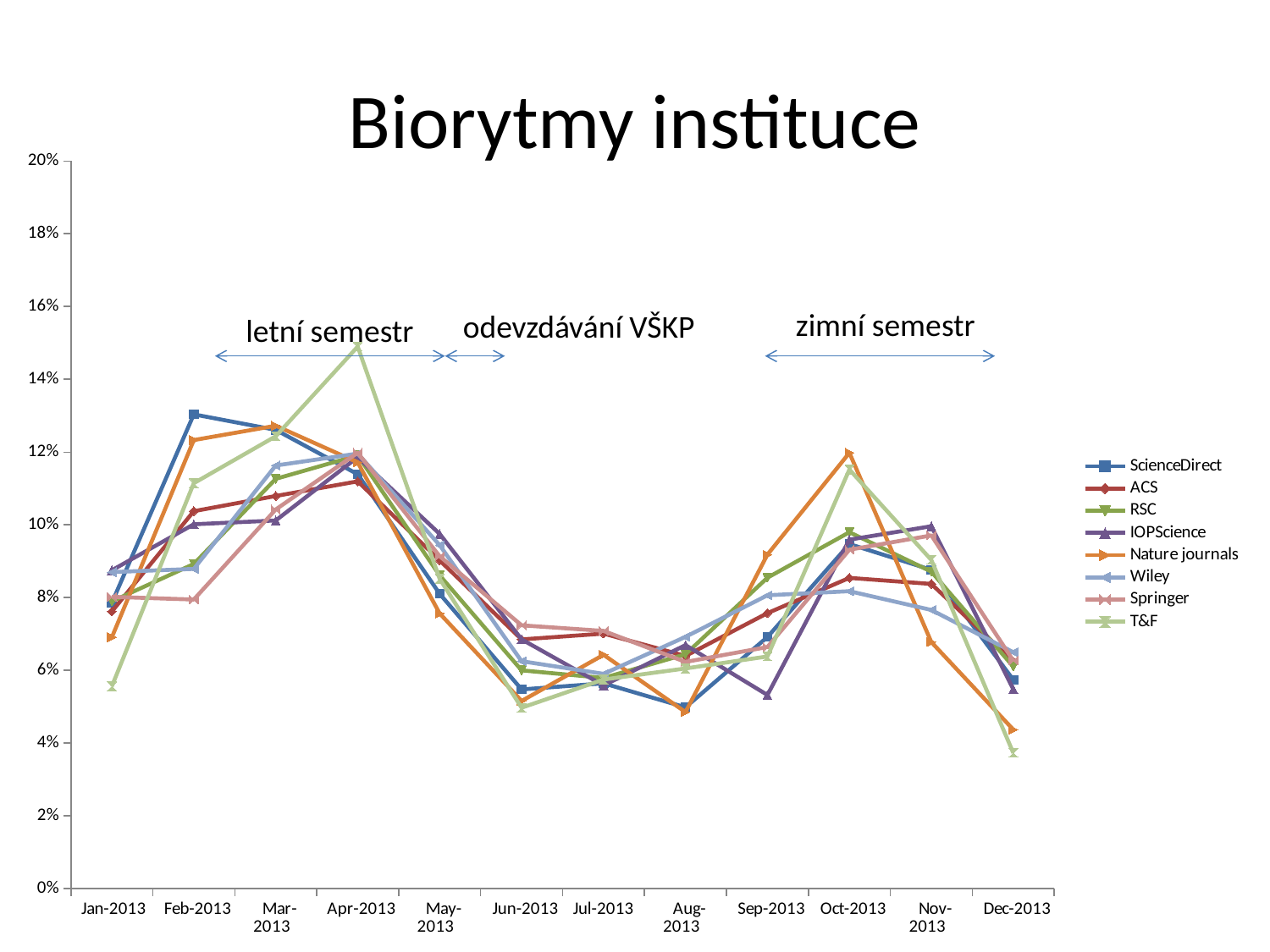
Which series has the lowest value in Jan-2013? T&F Which series reaches the highest value in Apr-2013? T&F How many series does the legend list? 8 What kind of chart is shown on the slide? line chart Is the value for IOPScience in Sep-2013 greater or less than 6%? less Is the value for Nature journals higher in Oct-2013 or in Nov-2013? Oct-2013 Which series has the highest value in Feb-2013? ScienceDirect Is the value for T&F in Apr-2013 greater or less than 14%? greater In which month does the T&F series reach its highest value? Apr-2013 Is the value for T&F in Dec-2013 greater or less than 4%? less What is the title of the chart? Biorytmy instituce How many months are plotted along the x axis? 12